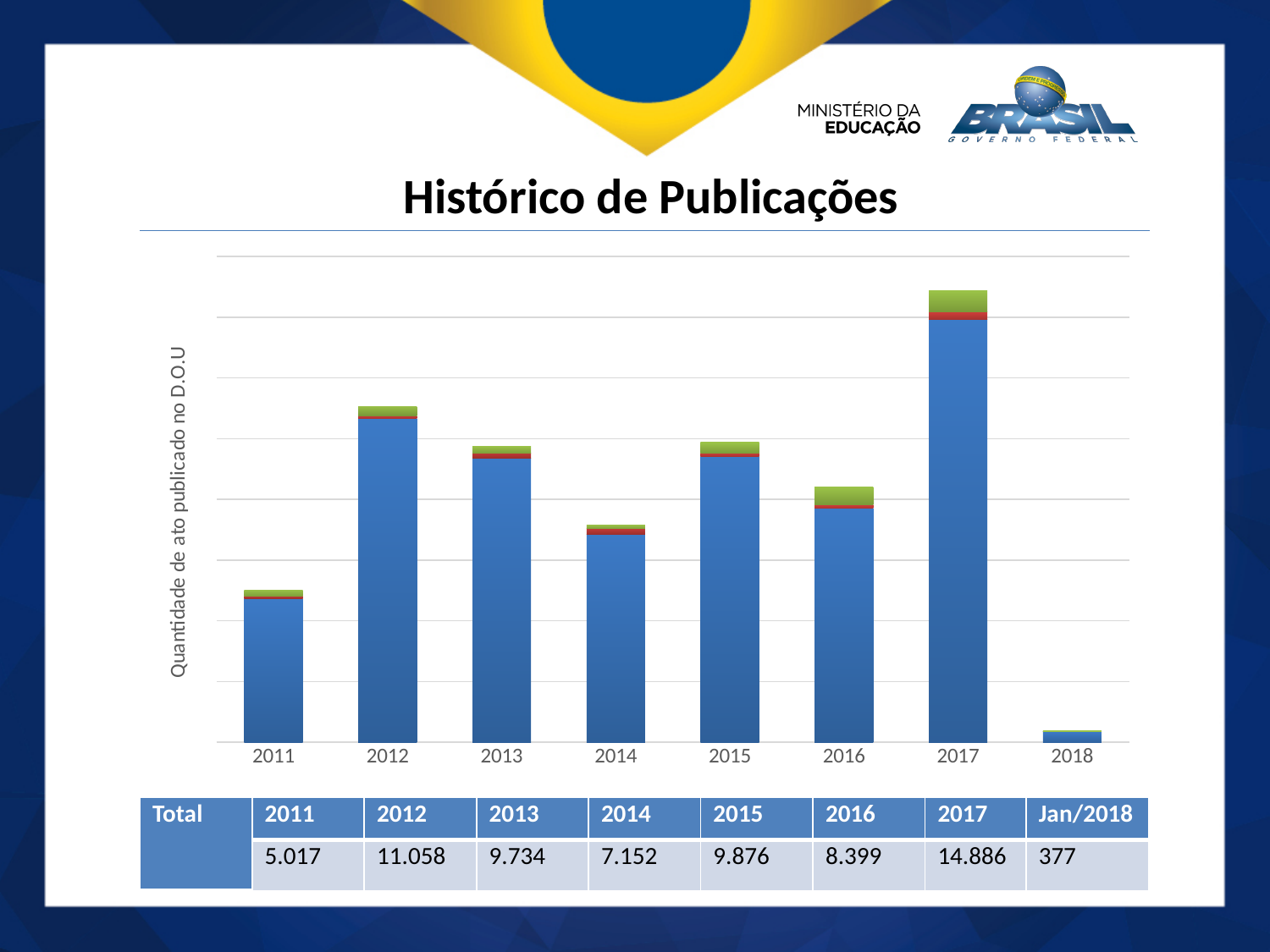
What is the total for 2011 shown in the table? 5.017 Which year has the lowest bar in the chart? 2018 How many years (categories) are plotted on the x axis of the chart? 8 Which year has the highest bar in the chart? 2017 Which is larger, the total for 2012 or the total for 2015? 2012 What is the total number of publications for 2017 according to the table below the chart? 14.886 What is the label on the y axis of the chart? Quantidade de ato publicado no D.O.U Do the bars rise or fall from 2012 to 2014? fall What is the difference between the totals for 2017 and 2011? 9.869 What is the title of the chart? Histórico de Publicações What is the total for Jan/2018 shown in the table? 377 What kind of chart is shown on the slide? bar chart